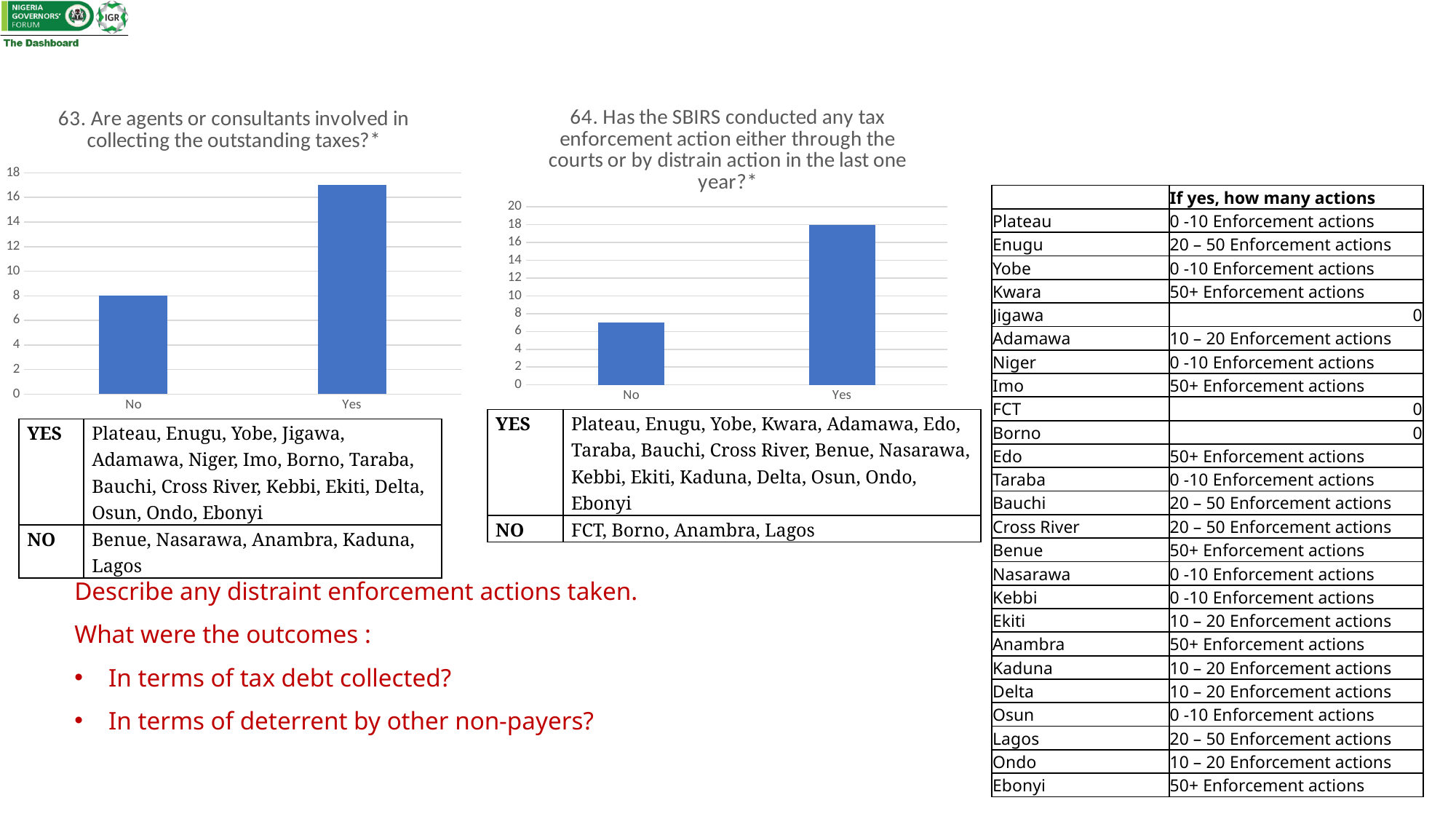
In the left chart (question 63), which category has the highest value? Yes What kind of chart is the right chart (question 64)? bar chart What are the two category labels on the x axis of the right chart (question 64)? No and Yes In the right chart (question 64), which category has the lowest value? No In the chart titled "63. Are agents or consultants involved in collecting the outstanding taxes?", what is the value for No? 8 In the right chart (question 64), which is larger, the value for No or the value for Yes? Yes In the left chart (question 63), is the value for Yes greater or less than 16? greater In the chart titled "64. Has the SBIRS conducted any tax enforcement action...", what is the value for Yes? 18 In the right chart (question 64), is the value for No greater or less than 8? less How many categories are shown on the x axis of the left chart (question 63)? 2 What is the highest tick value on the y axis of the right chart (question 64)? 20 In the left chart (question 63), do the values rise or fall from No to Yes? rise